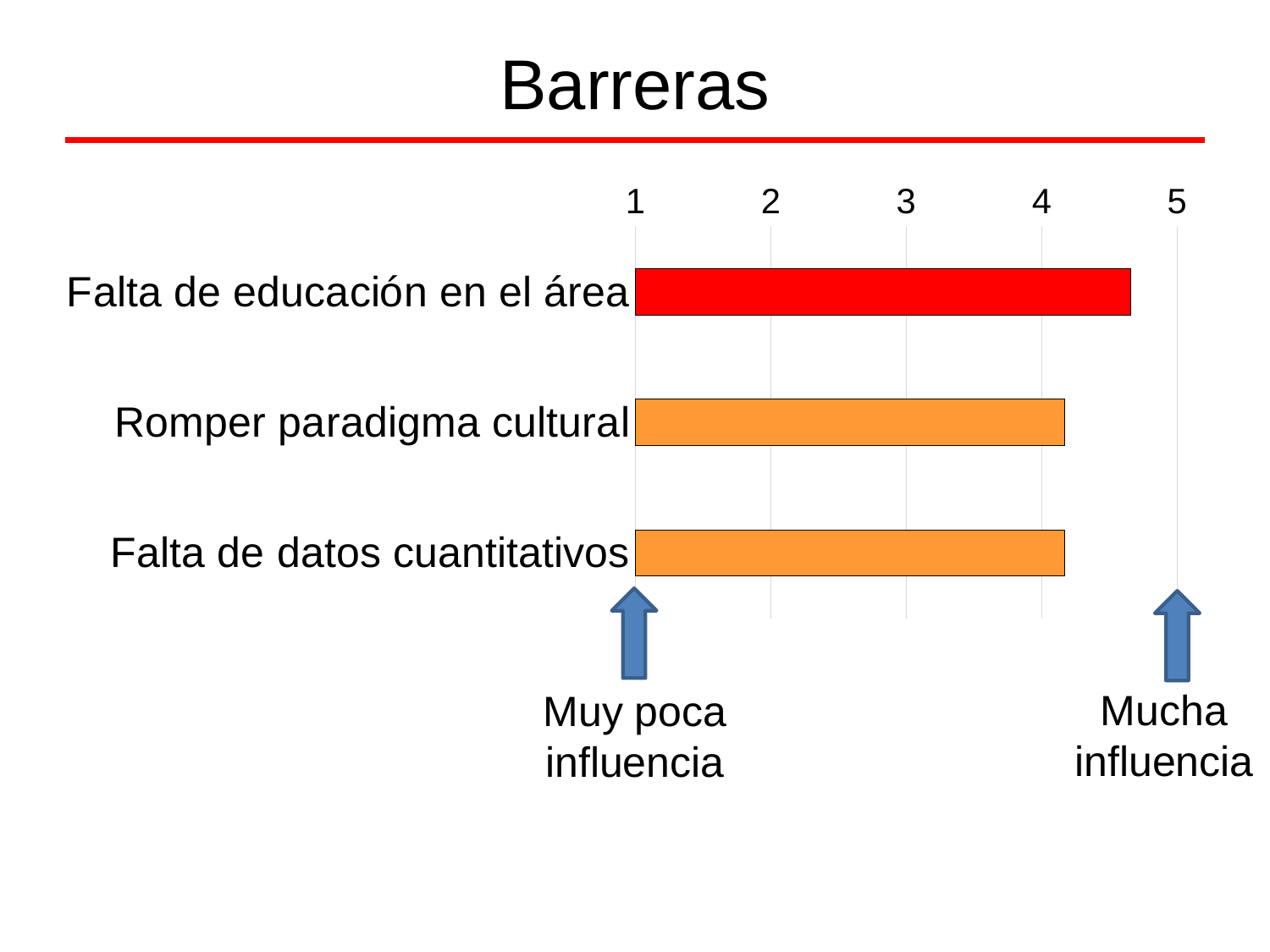
What is the title of the chart? Barreras Is the value for Falta de datos cuantitativos greater or less than 5? less Which bar is coloured red? Falta de educación en el área How many categories (bars) does the chart show? 3 Is the value for Romper paradigma cultural greater or less than 3? greater Is the value for Falta de educación en el área greater or less than 4? greater What is the highest value shown on the axis? 5 What kind of chart is shown on the slide? bar chart Which category has the highest value? Falta de educación en el área Which is larger, the value for Falta de educación en el área or the value for Romper paradigma cultural? Falta de educación en el área